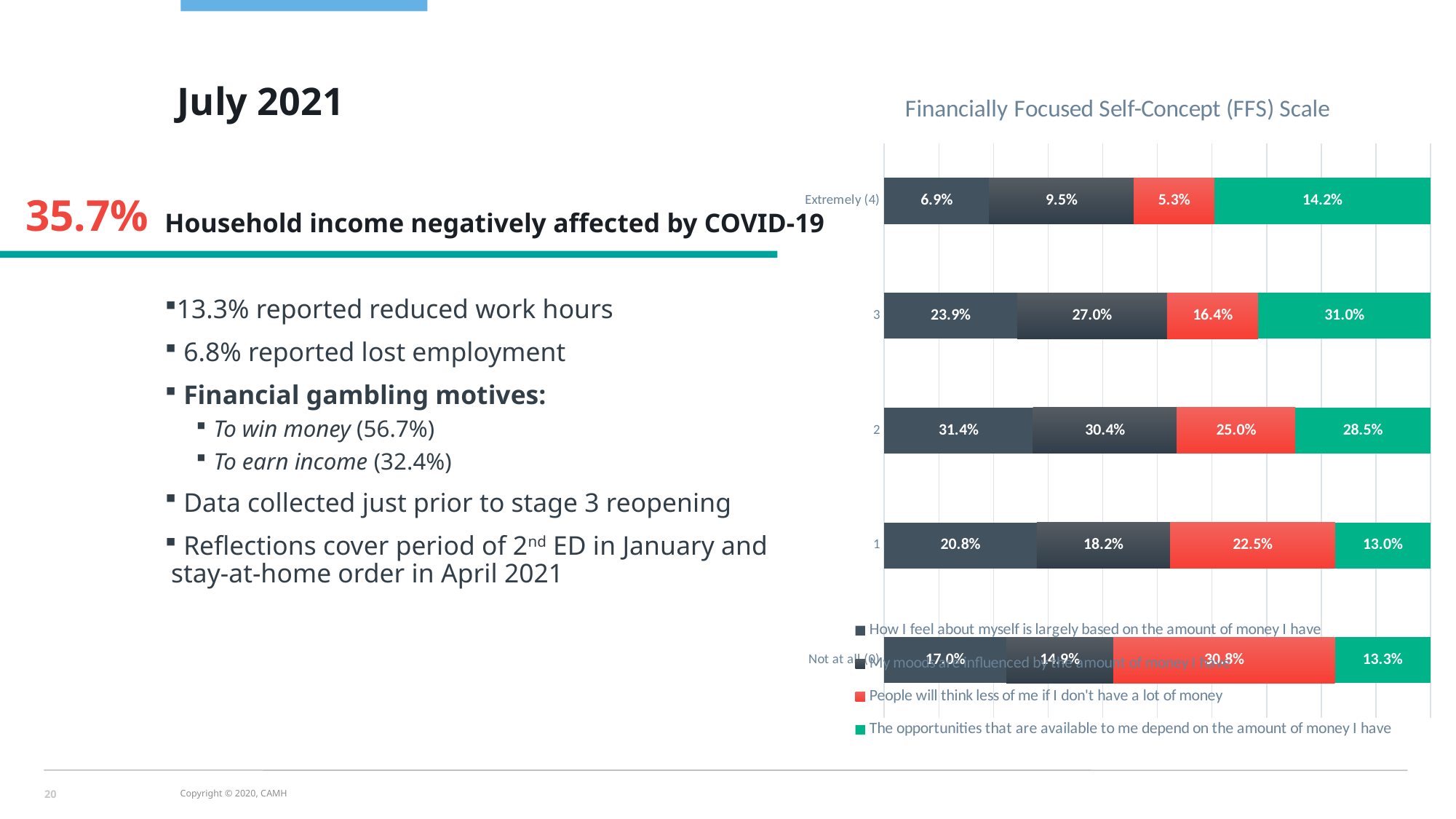
What kind of chart is shown on the slide? Stacked bar chart What is the value for 'The opportunities that are available to me depend on the amount of money I have' at 'Extremely (4)'? 14.2% For 'People will think less of me if I don't have a lot of money', which scale category has the highest value? Not at all (0) What is the value for 'The opportunities that are available to me depend on the amount of money I have' at scale point 3? 31.0% How many scale categories are plotted on the chart's vertical axis? 5 What is the value for 'People will think less of me if I don't have a lot of money' at scale point 2? 25.0% What is the title of the chart on the slide? Financially Focused Self-Concept (FFS) Scale How many series does the chart's legend list? 4 For 'The opportunities that are available to me depend on the amount of money I have', which is larger: the value at scale point 2 or at scale point 3? 3 What is the value for 'People will think less of me if I don't have a lot of money' at 'Not at all (0)'? 30.8% For 'The opportunities that are available to me depend on the amount of money I have', which scale category has the highest value? 3 What is the difference between the 'People will think less of me if I don't have a lot of money' values at 'Not at all (0)' and 'Extremely (4)'? 25.5 percentage points